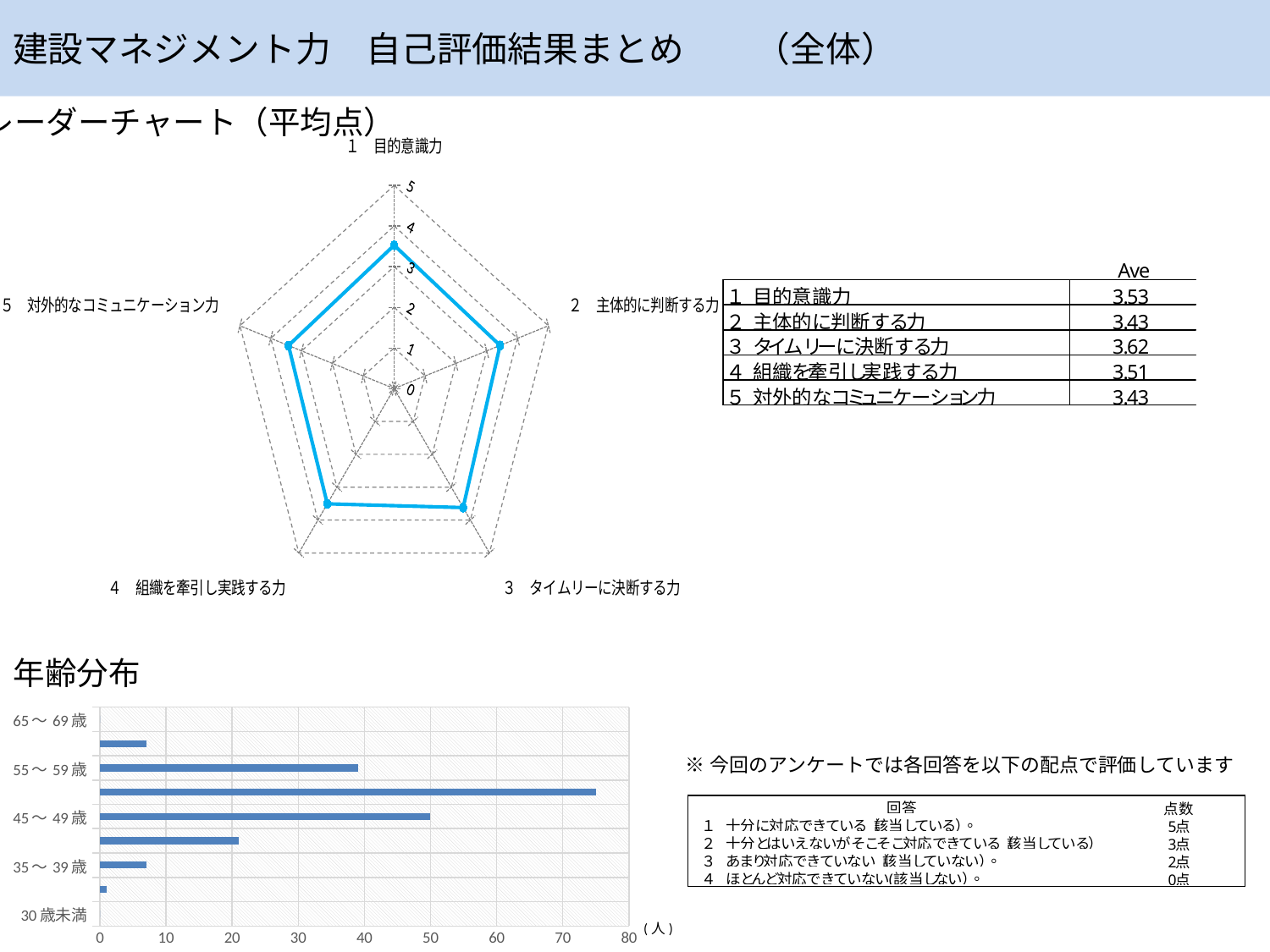
In the レーダーチャート（平均点） chart, what is the difference between the scores for 3 タイムリーに決断する力 and 5 対外的なコミュニケーション力? 0.19 In the レーダーチャート（平均点） chart, what is the average score for 1 目的意識力? 3.53 In the 年齢分布 chart, is the value for 35〜39歳 greater or less than 10? less In the 年齢分布 chart, is the value for 55〜59歳 greater or less than 30? greater What type of chart is the レーダーチャート（平均点） chart? radar chart What type of chart is the 年齢分布 chart? bar chart In the レーダーチャート（平均点） chart, is the value for 2 主体的に判断する力 greater or less than 4? less In the レーダーチャート（平均点） chart, which category has the highest average score? 3 タイムリーに決断する力 In the レーダーチャート（平均点） chart, how many categories (axes) are plotted? 5 In the レーダーチャート（平均点） chart, what is the average score for 3 タイムリーに決断する力? 3.62 In the レーダーチャート（平均点） chart, which is larger: the score for 3 タイムリーに決断する力 or 2 主体的に判断する力? 3 タイムリーに決断する力 In the レーダーチャート（平均点） chart, what is the average score for 4 組織を牽引し実践する力? 3.51